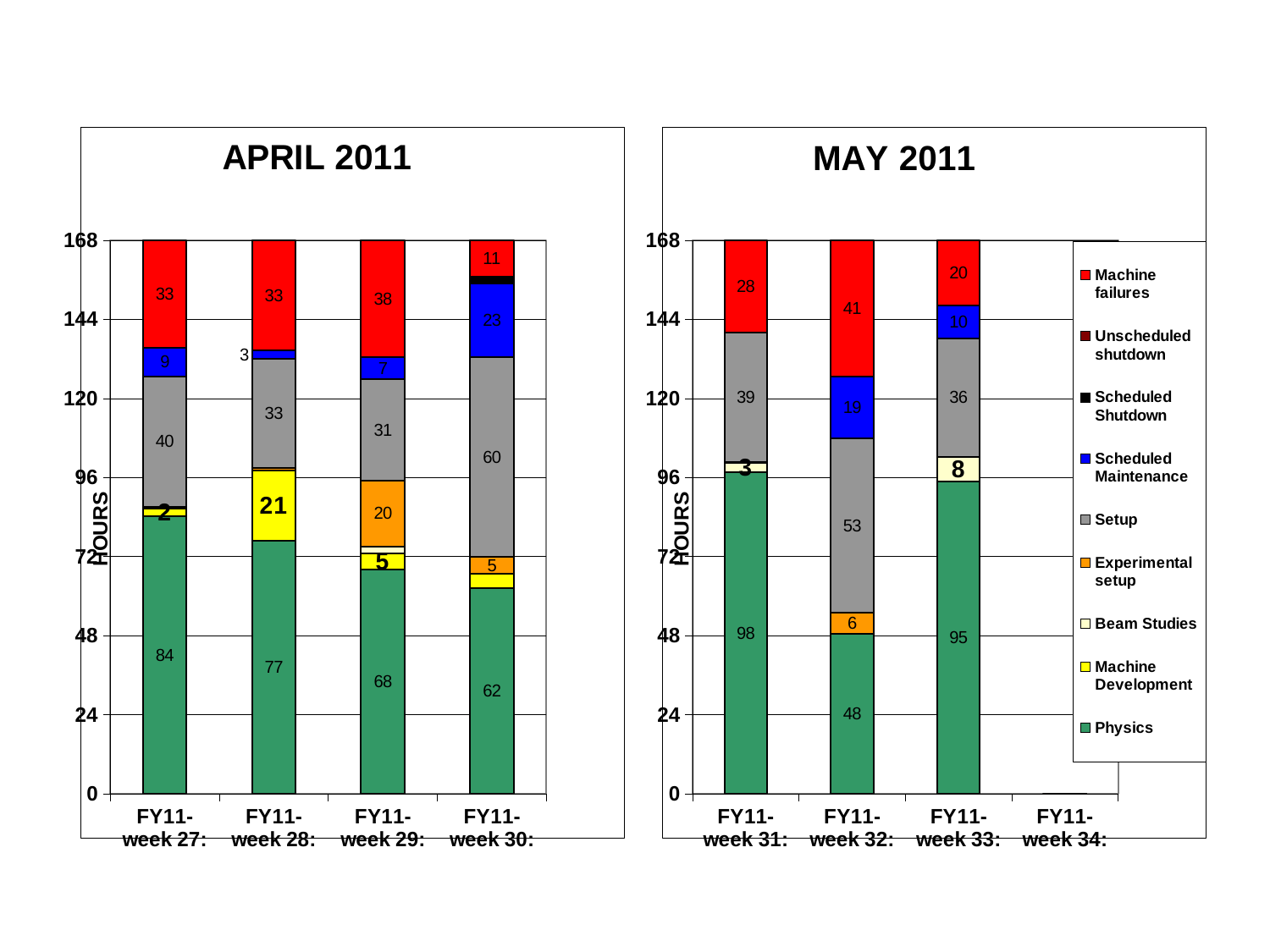
In the MAY 2011 chart, how many Physics hours are shown for FY11-week 32? 48 In the APRIL 2011 chart, which week has the highest Physics hours? FY11-week 27 In the APRIL 2011 chart, what is the difference in Physics hours between FY11-week 27 and FY11-week 30? 22 In the MAY 2011 chart, how many Setup hours are shown for FY11-week 32? 53 In the APRIL 2011 chart, how many Machine failures hours are shown for FY11-week 29? 38 In the APRIL 2011 chart, how many Setup hours are shown for FY11-week 30? 60 How many series does the legend on the MAY 2011 chart list? 9 What kind of chart is the APRIL 2011 chart? Stacked bar chart In the APRIL 2011 chart, how many Machine Development hours are shown for FY11-week 28? 21 In the MAY 2011 chart, which week has more Machine failures hours, FY11-week 32 or FY11-week 33? FY11-week 32 In the APRIL 2011 chart, how many Physics hours are shown for FY11-week 27? 84